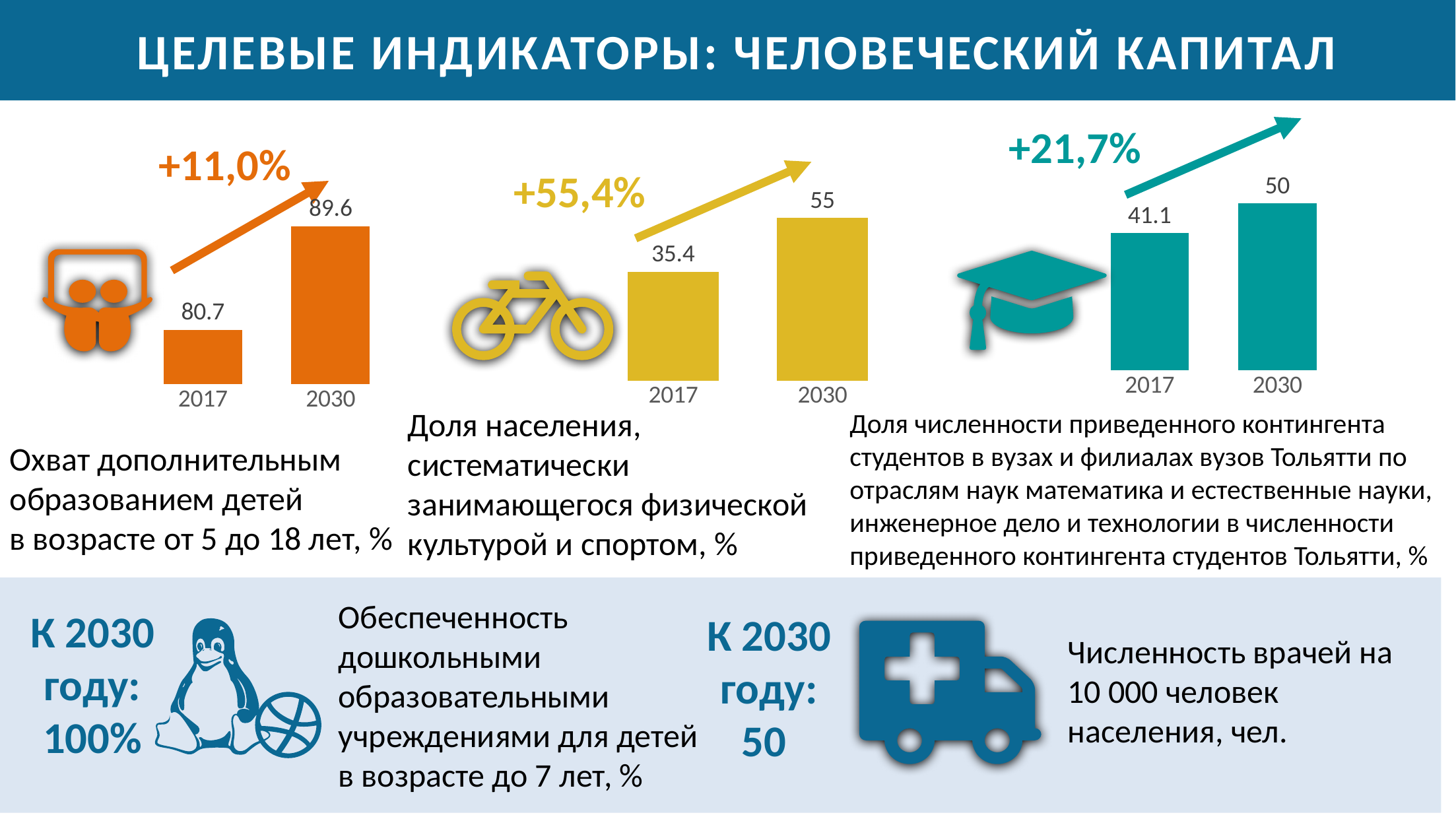
What type of chart is used for the three indicators in the upper part of the slide? Bar chart In the right (teal) chart, which year has the higher value, 2017 or 2030? 2030 How many bars does the middle (yellow) chart contain? 2 In the left (orange) chart, what is the difference between the 2030 and 2017 values? 8.9 What percentage growth is annotated above the right (teal) chart? +21,7% In the middle (yellow) chart on the share of population regularly engaged in physical culture and sport, what is the value for 2017? 35.4 In the right (teal) chart on the share of students in mathematics, natural sciences, engineering and technology, what is the value for 2030? 50 In the left (orange) chart on coverage of supplementary education for children aged 5 to 18, what is the value for 2030? 89.6 In the middle (yellow) chart, what is the difference between the 2030 and 2017 values? 19.6 In the left (orange) chart on coverage of supplementary education for children aged 5 to 18, what is the value for 2017? 80.7 In the right (teal) chart on the share of students in mathematics, natural sciences, engineering and technology, what is the value for 2017? 41.1 In the middle (yellow) chart on the share of population regularly engaged in physical culture and sport, what is the value for 2030? 55